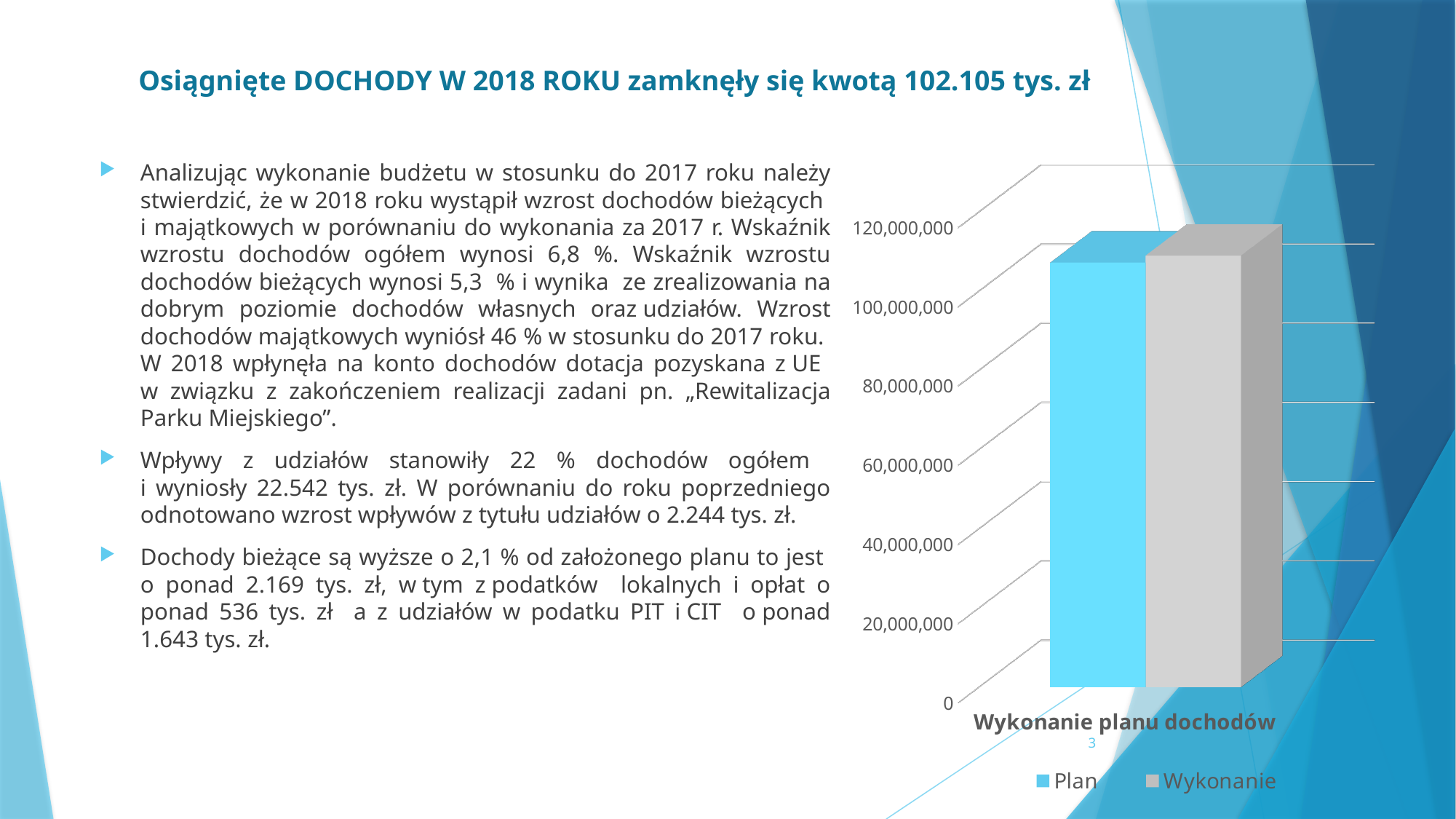
What is the highest tick value shown on the vertical axis of the chart? 120,000,000 How many categories are shown on the x axis of the chart? 1 What are the two series named in the chart legend? Plan and Wykonanie Is the value of the Wykonanie bar greater or less than 80,000,000? greater What is the category label shown under the bars? Wykonanie planu dochodów Is the value of the Plan bar greater or less than 120,000,000? less What kind of chart is shown on the slide? bar chart How many series does the chart legend list? 2 Is the value of the Wykonanie bar greater or less than 120,000,000? less